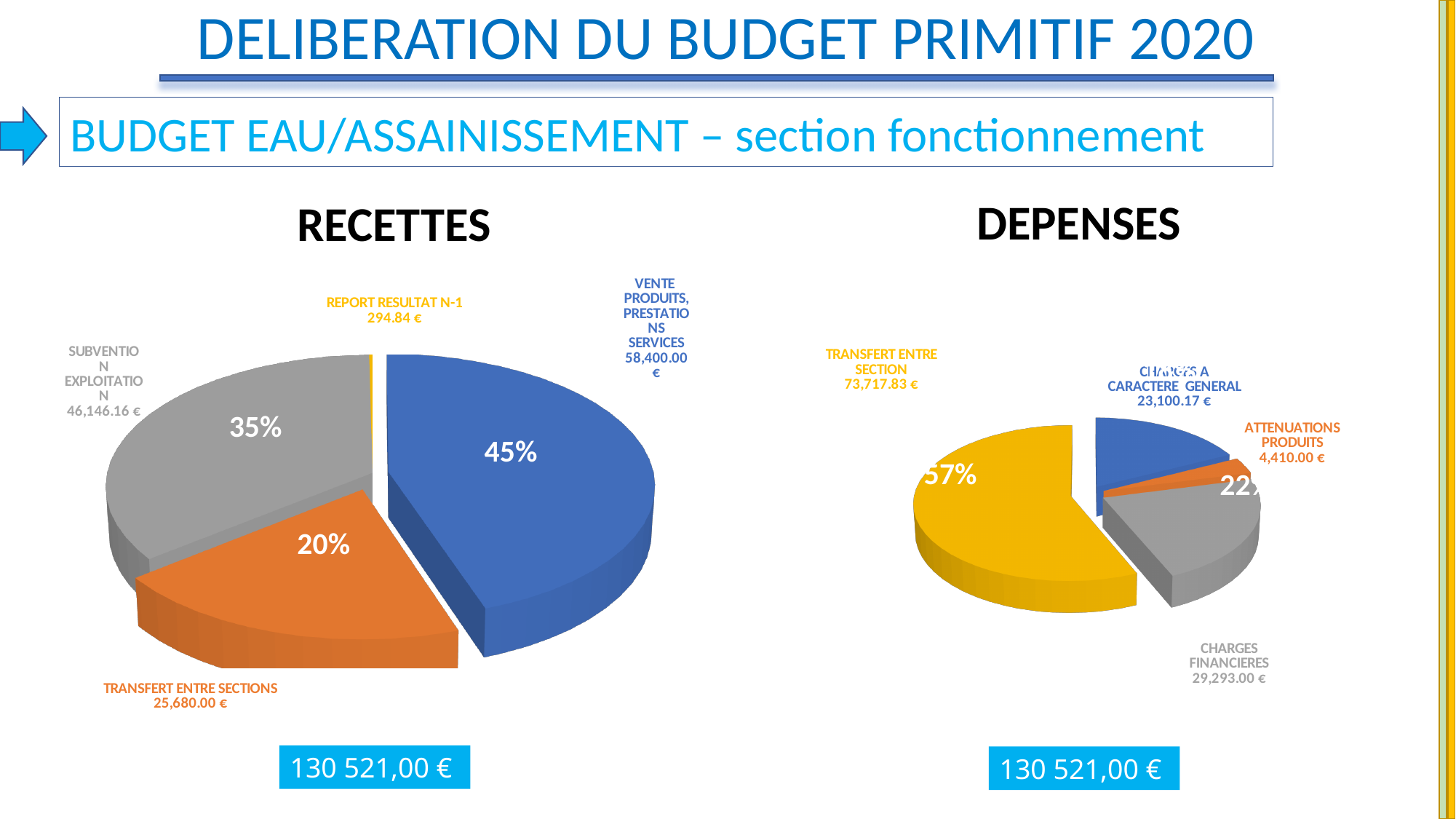
In the DEPENSES chart, what is the value for CHARGES FINANCIERES? 29,293.00 € In the DEPENSES chart, which category has the smallest value? ATTENUATIONS PRODUITS In the DEPENSES chart, which is larger: CHARGES A CARACTERE GENERAL or CHARGES FINANCIERES? CHARGES FINANCIERES In the RECETTES chart, what is the value for REPORT RESULTAT N-1? 294.84 € In the RECETTES chart, which category has the smallest value? REPORT RESULTAT N-1 In the RECETTES chart, what percentage share is shown for TRANSFERT ENTRE SECTIONS? 20% In the RECETTES chart, what is the value for SUBVENTION EXPLOITATION? 46,146.16 € How many categories does the RECETTES pie chart have? 4 In the DEPENSES chart, what is the value for TRANSFERT ENTRE SECTION? 73,717.83 € What type of chart is the RECETTES chart? pie chart In the RECETTES chart, what is the value for VENTE PRODUITS, PRESTATIONS SERVICES? 58,400.00 € In the RECETTES chart, which category has the largest value? VENTE PRODUITS, PRESTATIONS SERVICES